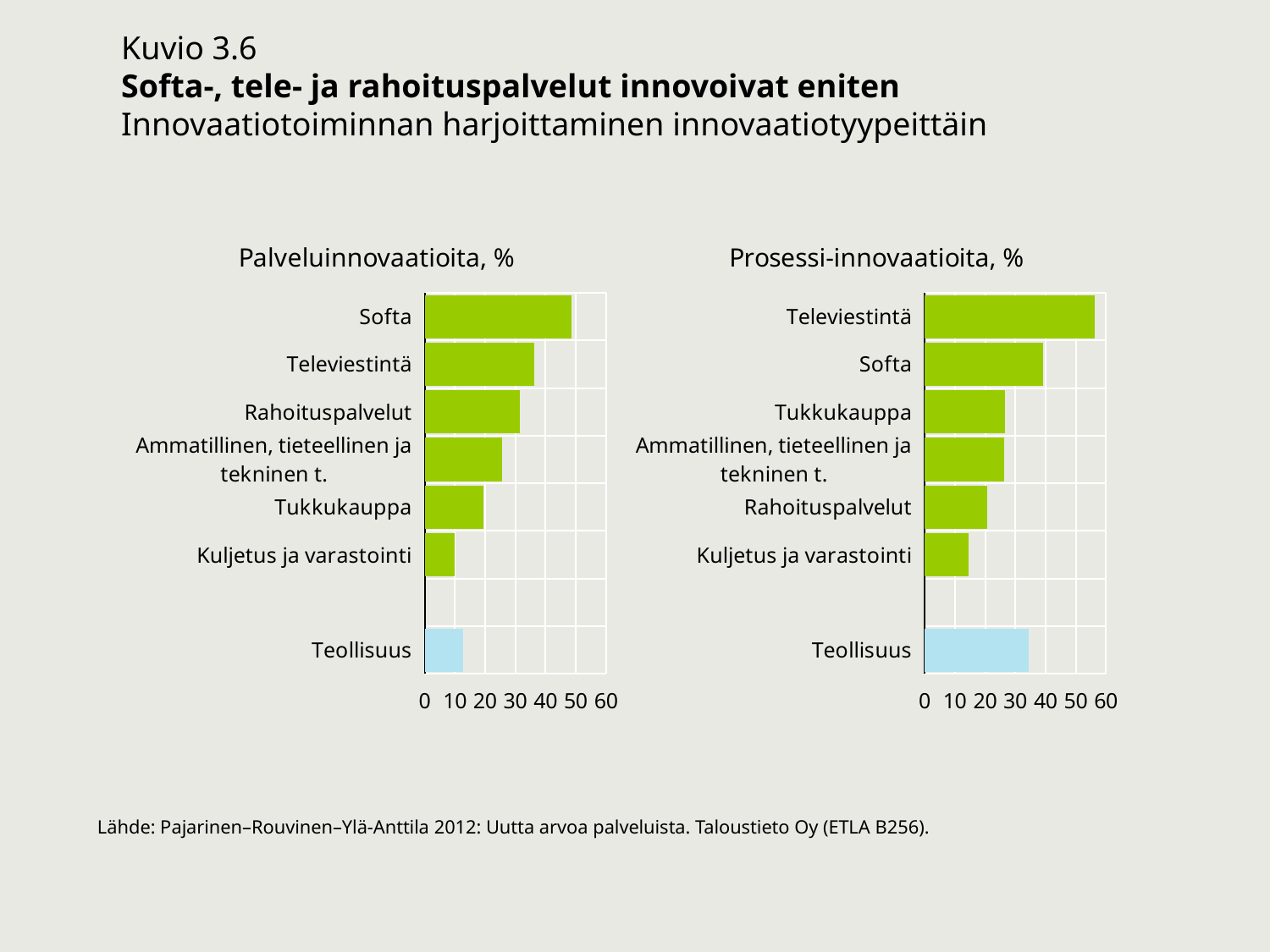
In the right chart "Prosessi-innovaatioita, %", is the value for Televiestintä greater or less than 50? greater In the left chart "Palveluinnovaatioita, %", which category has the highest value? Softa In the left chart "Palveluinnovaatioita, %", which is larger, the value for Softa or the value for Televiestintä? Softa In the right chart "Prosessi-innovaatioita, %", which category has the lowest value? Kuljetus ja varastointi In the right chart "Prosessi-innovaatioita, %", which is larger, the value for Rahoituspalvelut or the value for Teollisuus? Teollisuus How many categories are shown in the left chart "Palveluinnovaatioita, %"? 7 What kind of chart is the left chart titled "Palveluinnovaatioita, %"? bar chart In the right chart "Prosessi-innovaatioita, %", which category has the highest value? Televiestintä In the left chart "Palveluinnovaatioita, %", is the value for Kuljetus ja varastointi greater or less than 20? less What is the title of the right chart? Prosessi-innovaatioita, % In the left chart "Palveluinnovaatioita, %", is the value for Softa greater or less than 40? greater